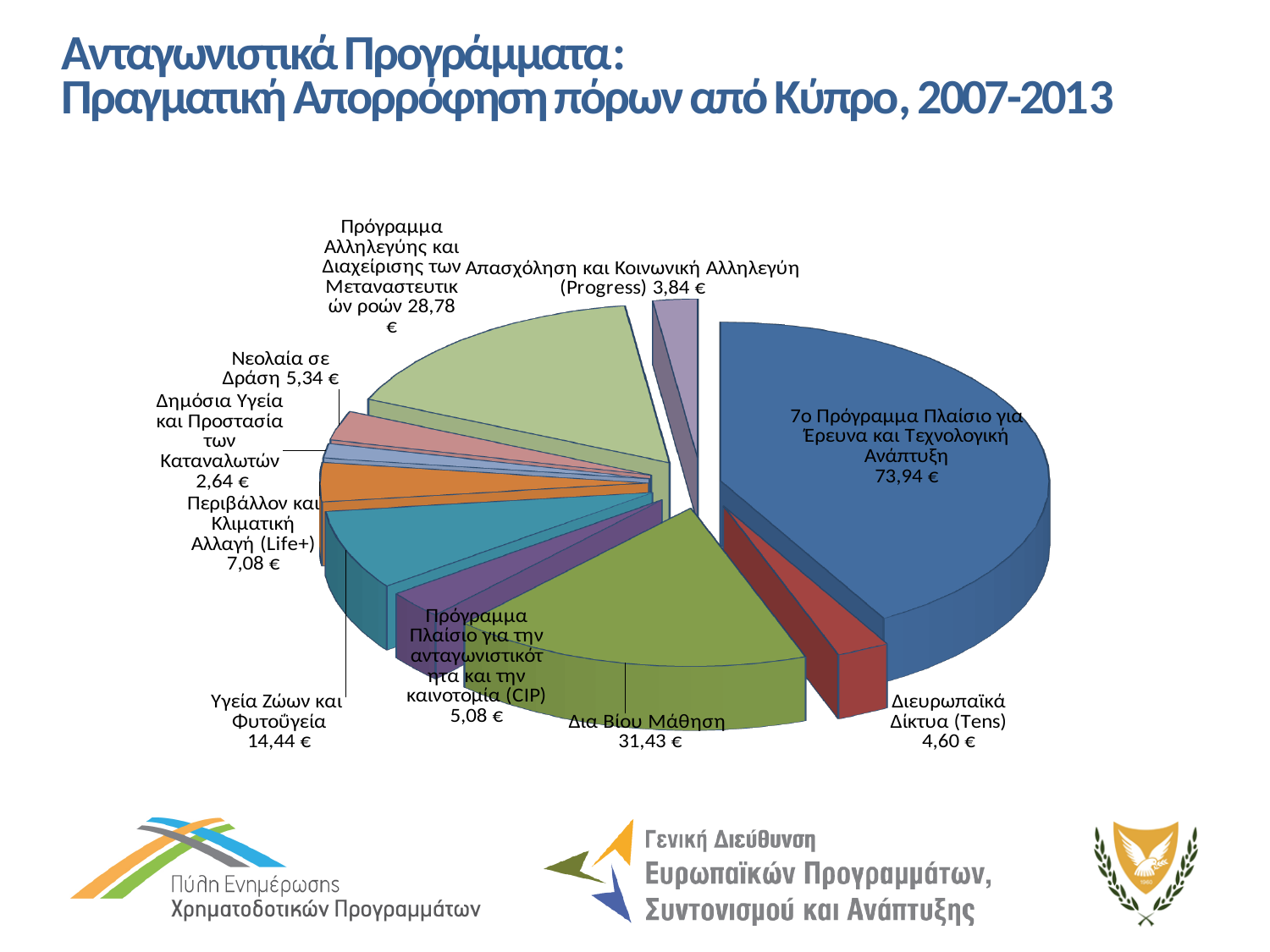
How many slices does the pie chart have? 10 Which slice of the pie has the largest value? 7ο Πρόγραμμα Πλαίσιο για Έρευνα και Τεχνολογική Ανάπτυξη What is the difference between the values for Περιβάλλον και Κλιματική Αλλαγή (Life+) and Δημόσια Υγεία και Προστασία των Καταναλωτών? 4,44 € What is the value for 7ο Πρόγραμμα Πλαίσιο για Έρευνα και Τεχνολογική Ανάπτυξη? 73,94 € Which slice of the pie has the smallest value? Δημόσια Υγεία και Προστασία των Καταναλωτών What is the difference between the values for 7ο Πρόγραμμα Πλαίσιο για Έρευνα και Τεχνολογική Ανάπτυξη and Δια Βίου Μάθηση? 42,51 € What kind of chart is shown on the slide? Pie chart What is the value for Υγεία Ζώων και Φυτοϋγεία? 14,44 € Which is larger: Νεολαία σε Δράση or Πρόγραμμα Πλαίσιο για την ανταγωνιστικότητα και την καινοτομία (CIP)? Νεολαία σε Δράση What is the value for Δια Βίου Μάθηση? 31,43 € What is the title of the slide? Ανταγωνιστικά Προγράμματα: Πραγματική Απορρόφηση πόρων από Κύπρο, 2007-2013 What is the value for Διευρωπαϊκά Δίκτυα (Tens)? 4,60 €